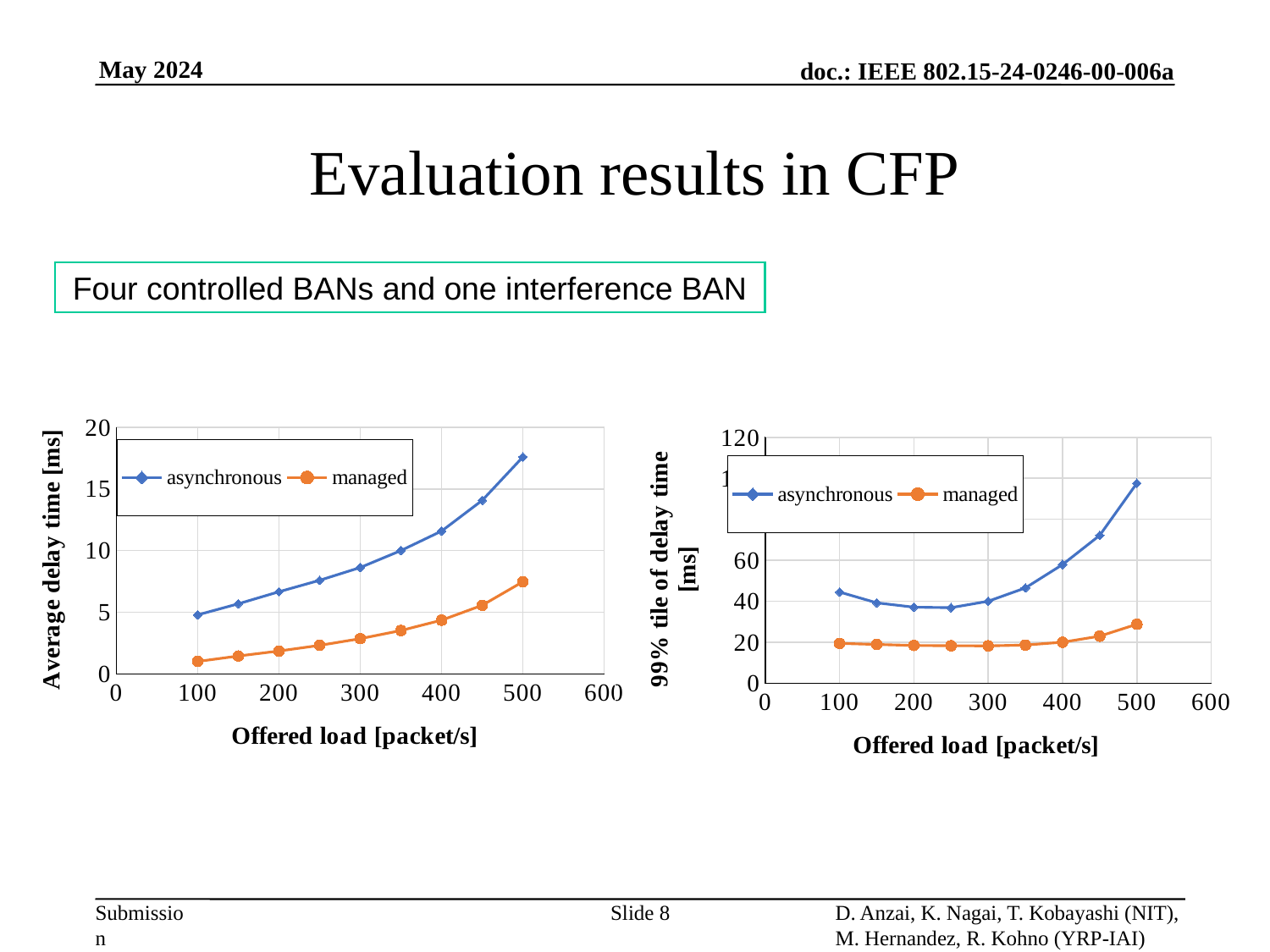
In the left chart (Average delay time), is the asynchronous value at an offered load of 300 packet/s greater or less than 10? less In the right chart (99% tile of delay time), is the asynchronous value at an offered load of 500 packet/s greater or less than 60? greater In the right chart (99% tile of delay time), which series has the lower value at an offered load of 100 packet/s, asynchronous or managed? managed In the left chart (Average delay time), does the asynchronous series rise or fall as offered load increases? rise What is the x-axis title of the right chart (99% tile of delay time)? Offered load [packet/s] What kind of chart is the left chart (Average delay time)? line chart In the left chart (Average delay time), which series has the higher value at an offered load of 500 packet/s, asynchronous or managed? asynchronous In the left chart (Average delay time), is the asynchronous value at an offered load of 500 packet/s greater or less than 15? greater In the left chart (Average delay time), how many data points are plotted for the managed series? 9 How many series does the legend of the right chart (99% tile of delay time) list? 2